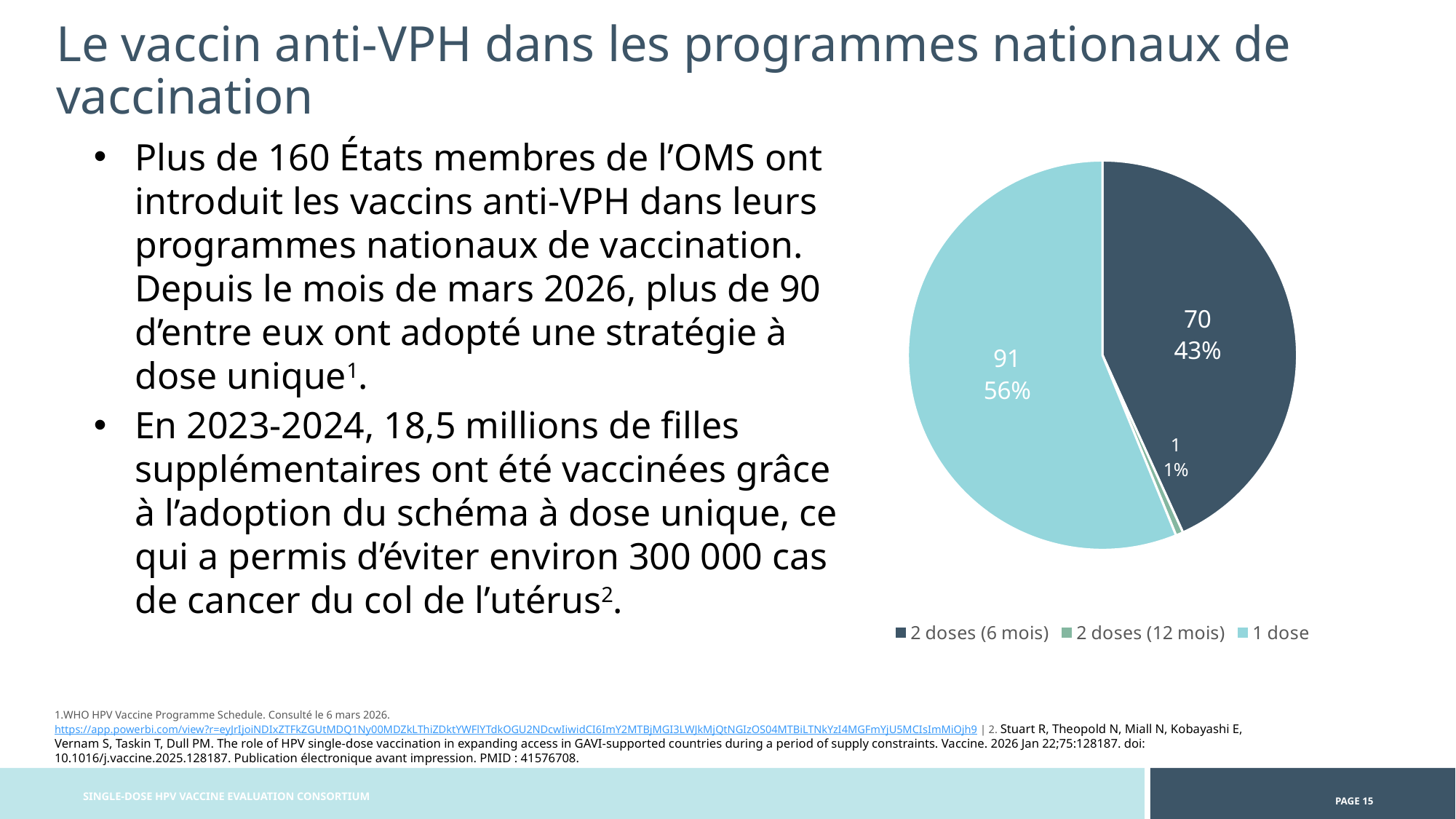
What is the value shown for the '2 doses (12 mois)' slice of the pie chart? 1 What kind of chart is shown on the slide? pie chart How many slices does the pie chart have? 3 How many entries does the legend of the pie chart list? 3 What share of the pie does the '2 doses (6 mois)' slice represent? 43% Which is larger, the value for '2 doses (6 mois)' or the value for '1 dose'? 1 dose What is the value shown for the '2 doses (6 mois)' slice of the pie chart? 70 What share of the pie does the '1 dose' slice represent? 56% What is the difference between the values for '1 dose' and '2 doses (6 mois)'? 21 Which slice of the pie chart is the smallest? 2 doses (12 mois) What is the value shown for the '1 dose' slice of the pie chart? 91 Which slice of the pie chart is the largest? 1 dose